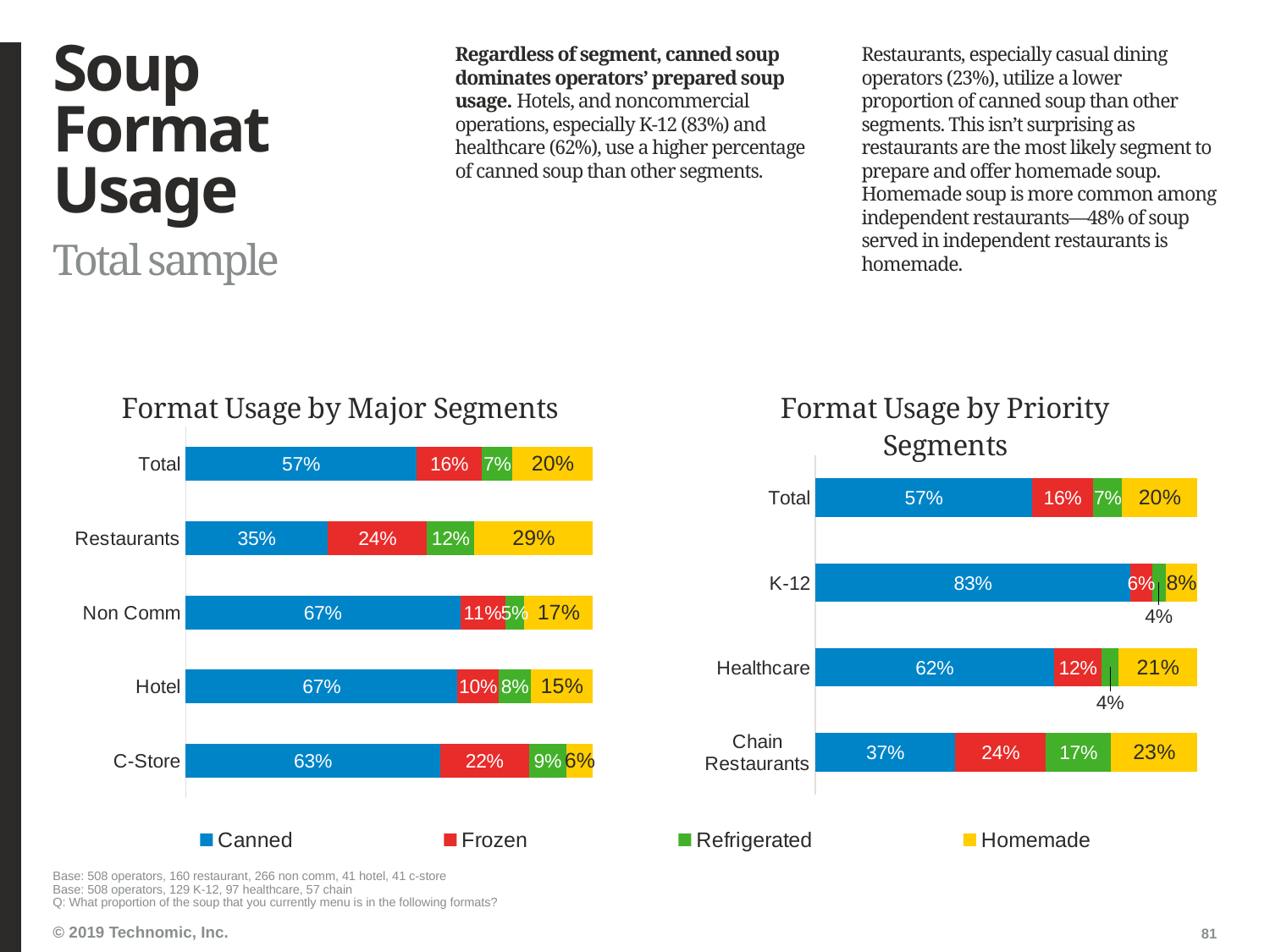
In the Format Usage by Major Segments chart, which segment has the lowest Canned share? Restaurants What type of chart is Format Usage by Priority Segments? Stacked bar chart In the Format Usage by Major Segments chart, how many segments are plotted? 5 In the Format Usage by Major Segments chart, what percentage of soup served by Restaurants is Canned? 35% In the Format Usage by Priority Segments chart, what is the Refrigerated value for Chain Restaurants? 17% In the Format Usage by Major Segments chart, what is the Homemade value for C-Store? 6% How many series does the legend list? 4 In the Format Usage by Major Segments chart, what is the difference between the Frozen values for C-Store and Hotel? 12% In the Format Usage by Priority Segments chart, what is the difference between the Canned values for K-12 and Healthcare? 21% In the Format Usage by Major Segments chart, which segment has the highest Homemade share? Restaurants In the Format Usage by Priority Segments chart, what is the Canned value for K-12? 83% In the Format Usage by Priority Segments chart, which is larger: the Homemade value for Healthcare or for Chain Restaurants? Chain Restaurants